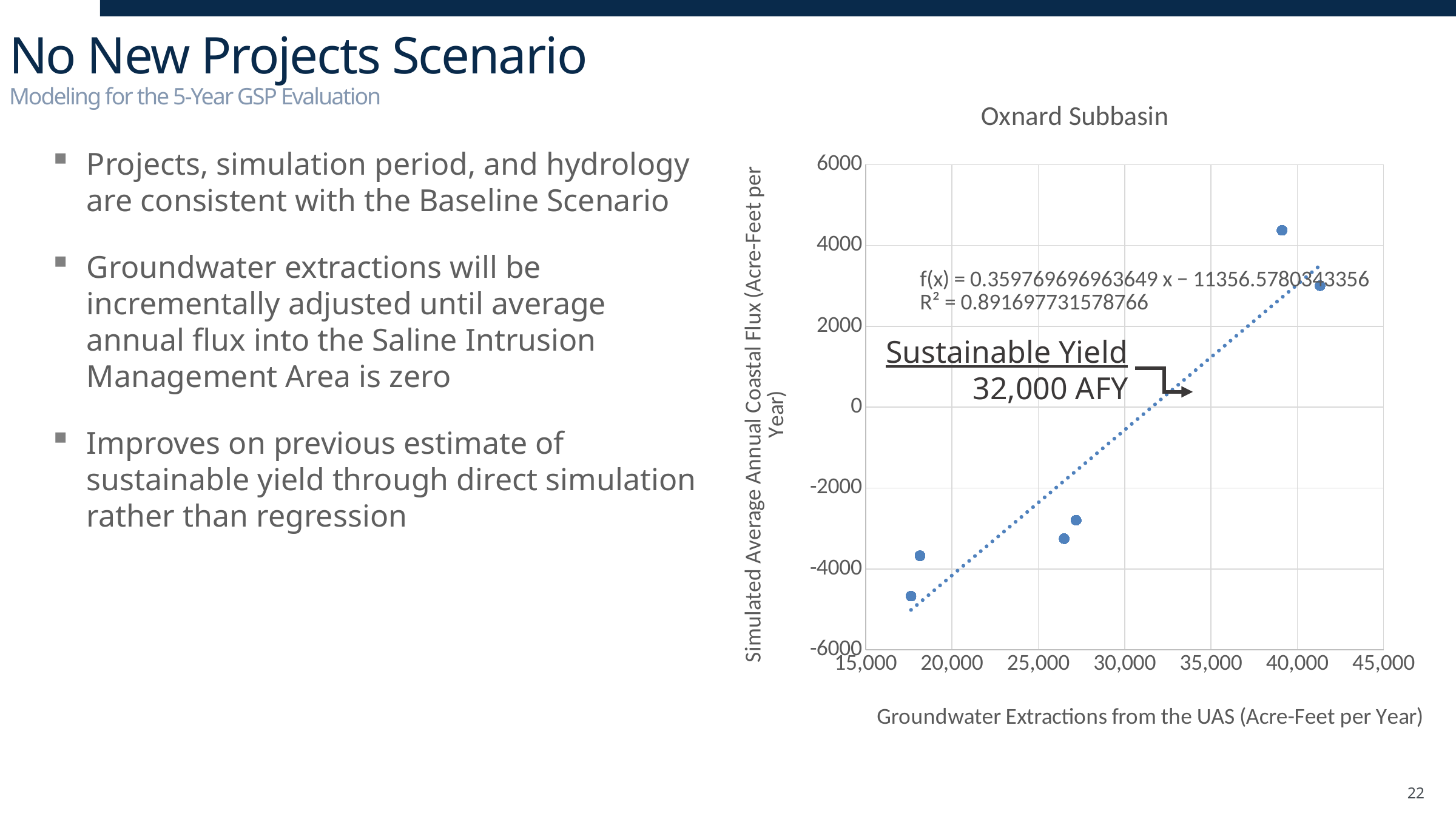
Is the simulated coastal flux for the data point with the lowest groundwater extraction (around 17,500) greater or less than -4000? less Which has the larger simulated coastal flux: the data point near 39,000 acre-feet per year of extraction or the data point near 27,000? the point near 39,000 How many data points are plotted on the chart? 6 What kind of chart is shown on the slide? scatter chart Do the plotted values rise or fall as groundwater extractions increase along the x axis? rise What is the R² value shown for the trendline on the chart? 0.891697731578766 Is the highest plotted coastal flux value on the chart greater or less than 4000? greater What is the label of the x axis of the chart? Groundwater Extractions from the UAS (Acre-Feet per Year) Is the simulated coastal flux for the data point with the highest groundwater extraction (around 41,500) greater or less than 2000? greater What sustainable yield value is annotated on the chart? 32,000 AFY What is the title of the chart? Oxnard Subbasin What is the slope coefficient in the trendline equation shown on the chart? 0.359769696963649